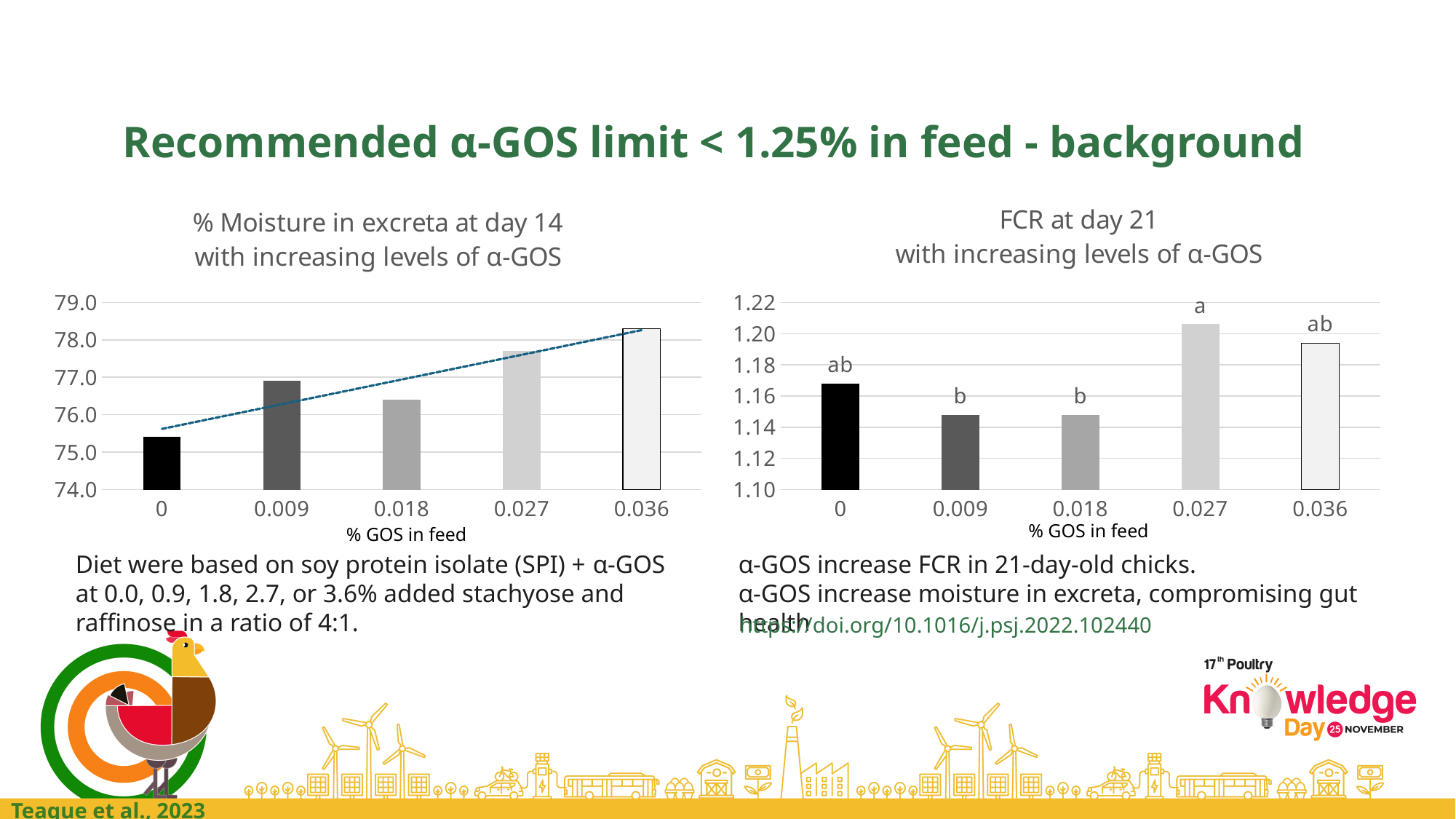
On the '% Moisture in excreta at day 14' chart, is the value for 0.036 % GOS greater or less than 78.0? greater On the 'FCR at day 21' chart, is the value for 0.009 % GOS greater or less than 1.16? less On the '% Moisture in excreta at day 14' chart, is the value for 0 % GOS greater or less than 76.0? less On the '% Moisture in excreta at day 14' chart, which % GOS in feed level has the highest moisture value? 0.036 On the '% Moisture in excreta at day 14' chart, which % GOS in feed level has the lowest moisture value? 0 On the 'FCR at day 21' chart, what letter label is shown above the bar for 0.027 % GOS? a On the 'FCR at day 21' chart, which has the higher FCR: 0 or 0.009 % GOS? 0 How many % GOS in feed levels are plotted on the 'FCR at day 21' chart? 5 On the '% Moisture in excreta at day 14' chart, which has the higher value: 0.009 or 0.018 % GOS? 0.009 What type of chart is the 'FCR at day 21' chart? bar chart On the '% Moisture in excreta at day 14' chart, does the dashed trend line rise or fall as % GOS in feed increases? rises